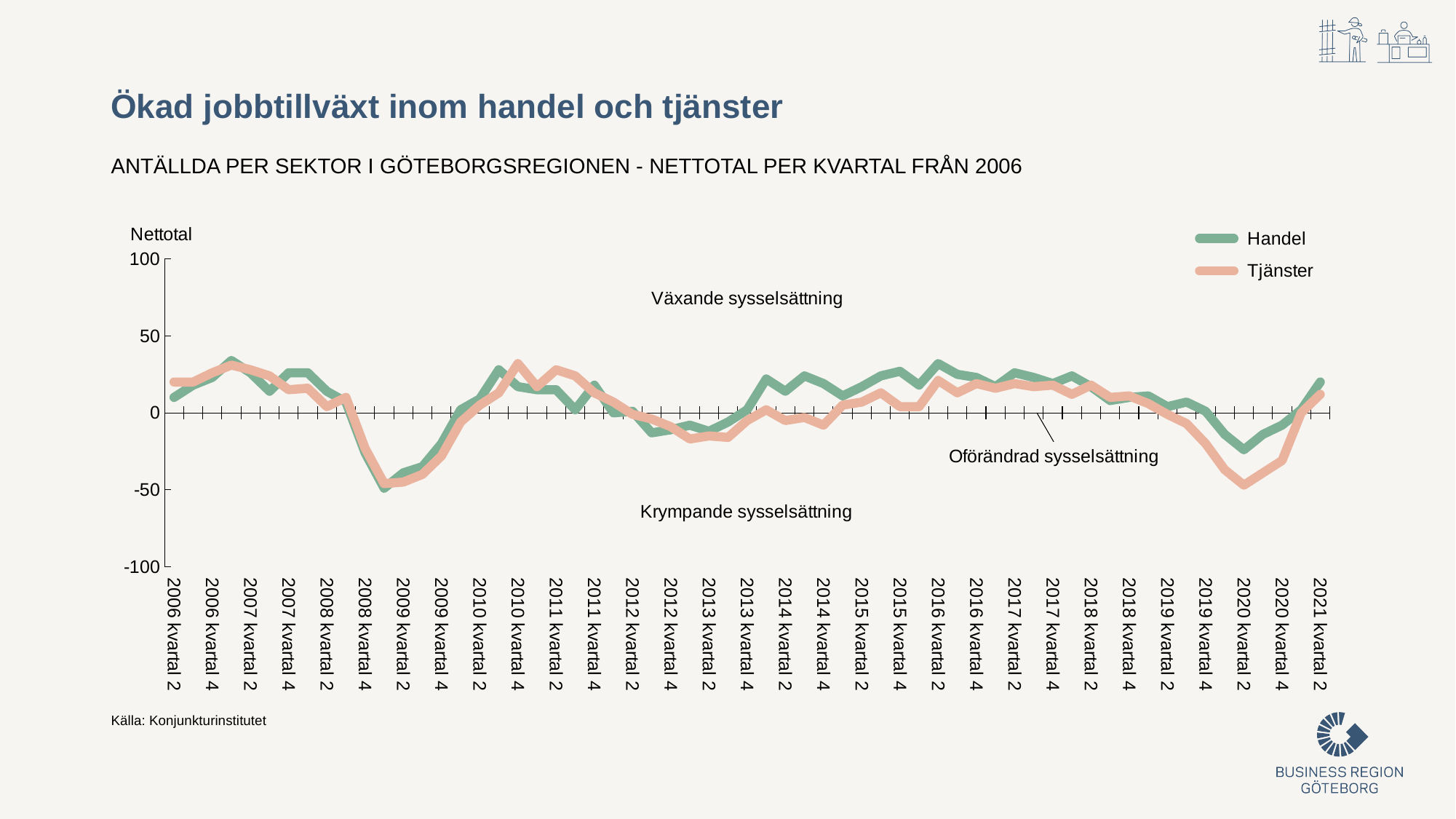
Is the value for Handel in 2016 kvartal 2 greater or less than 50? less What is the label on the vertical axis of the chart? Nettotal What kind of chart is shown on the slide? Line chart Between 2020 kvartal 2 and 2021 kvartal 2, does the Tjänster series rise or fall? Rise In 2010 kvartal 4, which series has the higher value, Handel or Tjänster? Tjänster Is the value for Tjänster in 2020 kvartal 2 greater or less than 0? less At which quarter does the Handel series reach its lowest value? 2009 kvartal 1 In 2020 kvartal 2, which series has the higher value, Handel or Tjänster? Handel Is the value for Tjänster in 2010 kvartal 4 greater or less than 0? greater Which two series are listed in the chart legend? Handel and Tjänster How many series does the legend list? 2